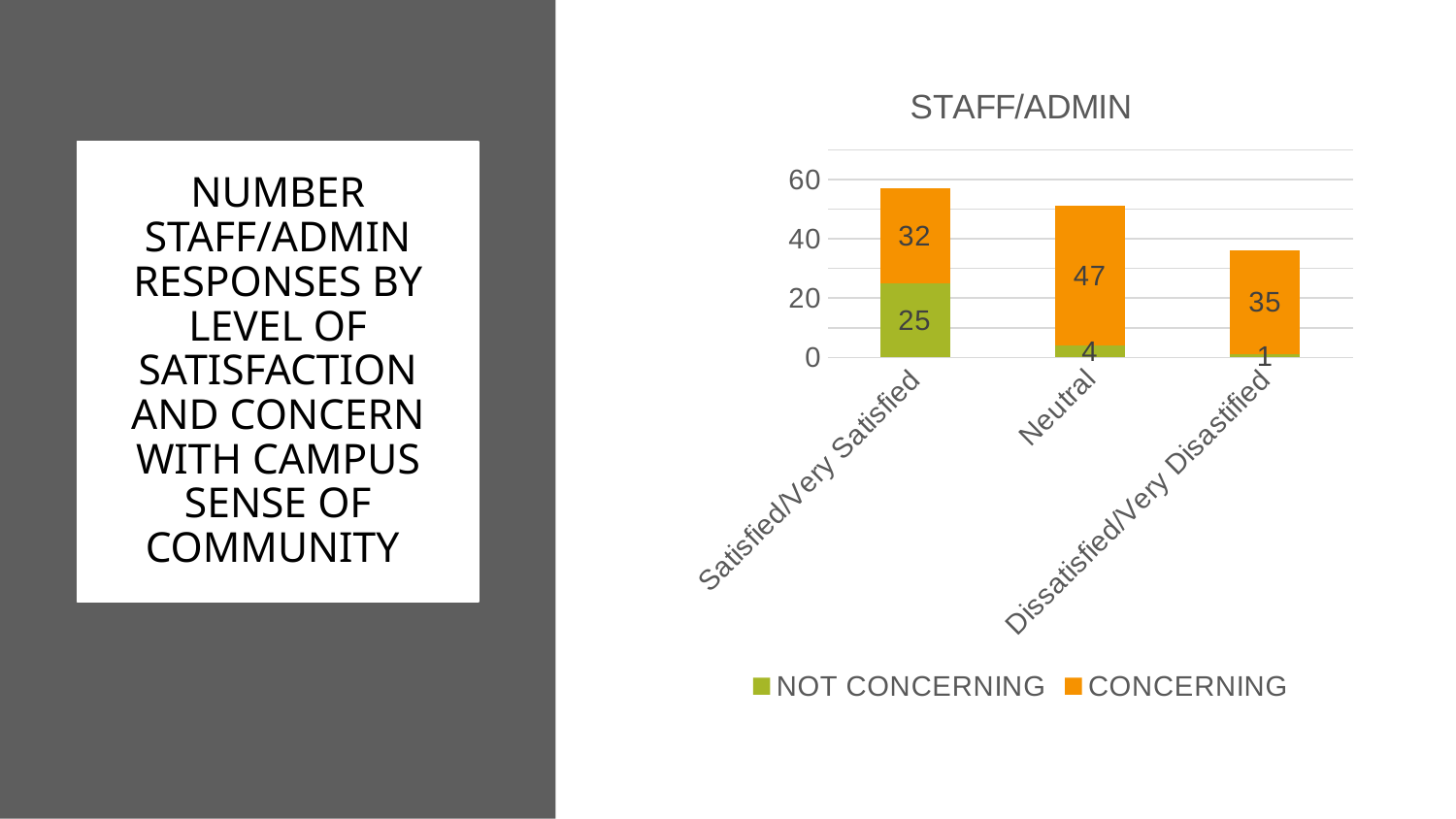
What is the NOT CONCERNING value for Satisfied/Very Satisfied? 25 Which category has the highest CONCERNING value? Neutral What kind of chart is shown? Stacked bar chart What is the difference between the CONCERNING values for Neutral and Satisfied/Very Satisfied? 15 What is the total of the stacked bar for Neutral? 51 What is the CONCERNING value for Dissatisfied/Very Disastified? 35 Which category has the lowest NOT CONCERNING value? Dissatisfied/Very Disastified Which is larger: the NOT CONCERNING value for Satisfied/Very Satisfied or the NOT CONCERNING value for Neutral? Satisfied/Very Satisfied What is the NOT CONCERNING value for Neutral? 4 What is the total of the stacked bar for Satisfied/Very Satisfied? 57 How many series does the legend list? 2 What is the CONCERNING value for Neutral? 47